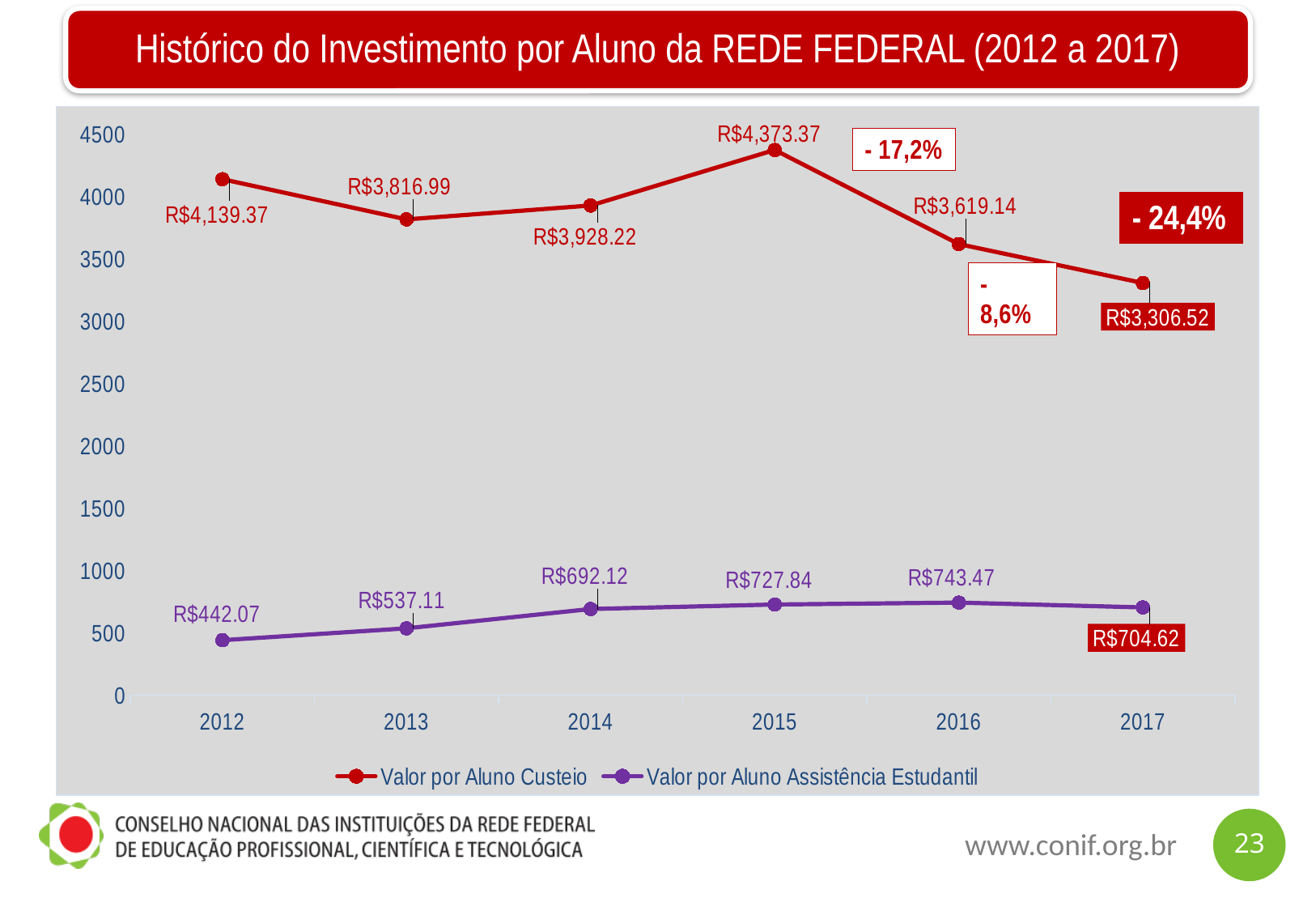
What is the difference between Valor por Aluno Custeio in 2015 and in 2017? R$1,066.85 Is the value for Valor por Aluno Custeio in 2016 greater or less than 4000? less Which is larger: Valor por Aluno Custeio in 2013 or in 2014? 2014 What is the value for Valor por Aluno Custeio in 2015? R$4,373.37 In which year is Valor por Aluno Custeio highest? 2015 What percentage change is shown in the large red box at the right of the chart? - 24,4% What is the value for Valor por Aluno Custeio in 2017? R$3,306.52 How many series does the legend list? 2 How many years are shown on the x axis? 6 What is the value for Valor por Aluno Assistência Estudantil in 2012? R$442.07 What kind of chart is shown on the slide? line chart In which year is Valor por Aluno Assistência Estudantil lowest? 2012